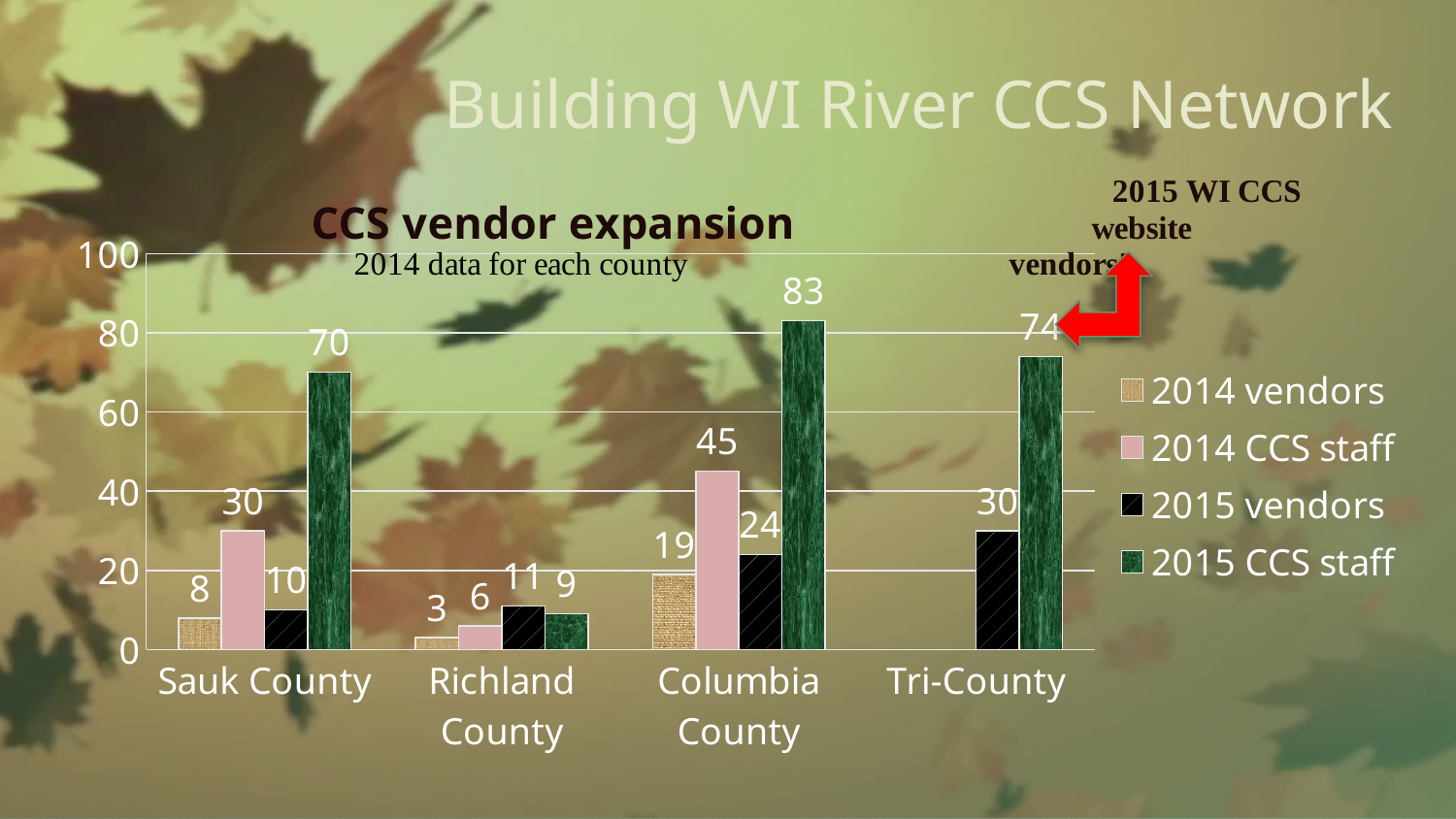
What is the title of the chart? CCS vendor expansion How many counties are shown on the x axis? 4 How many series does the legend list? 4 What is the difference between 2015 CCS staff and 2014 CCS staff in Sauk County? 40 Which county has the highest value for 2015 CCS staff? Columbia County What is the value for 2015 CCS staff in Columbia County? 83 Which county has the lowest value for 2014 vendors? Richland County What is the value for 2015 vendors in Tri-County? 30 What is the value for 2014 vendors in Richland County? 3 What is the value for 2014 CCS staff in Sauk County? 30 Which is larger in Richland County: 2015 vendors or 2015 CCS staff? 2015 vendors What kind of chart is shown? Bar chart